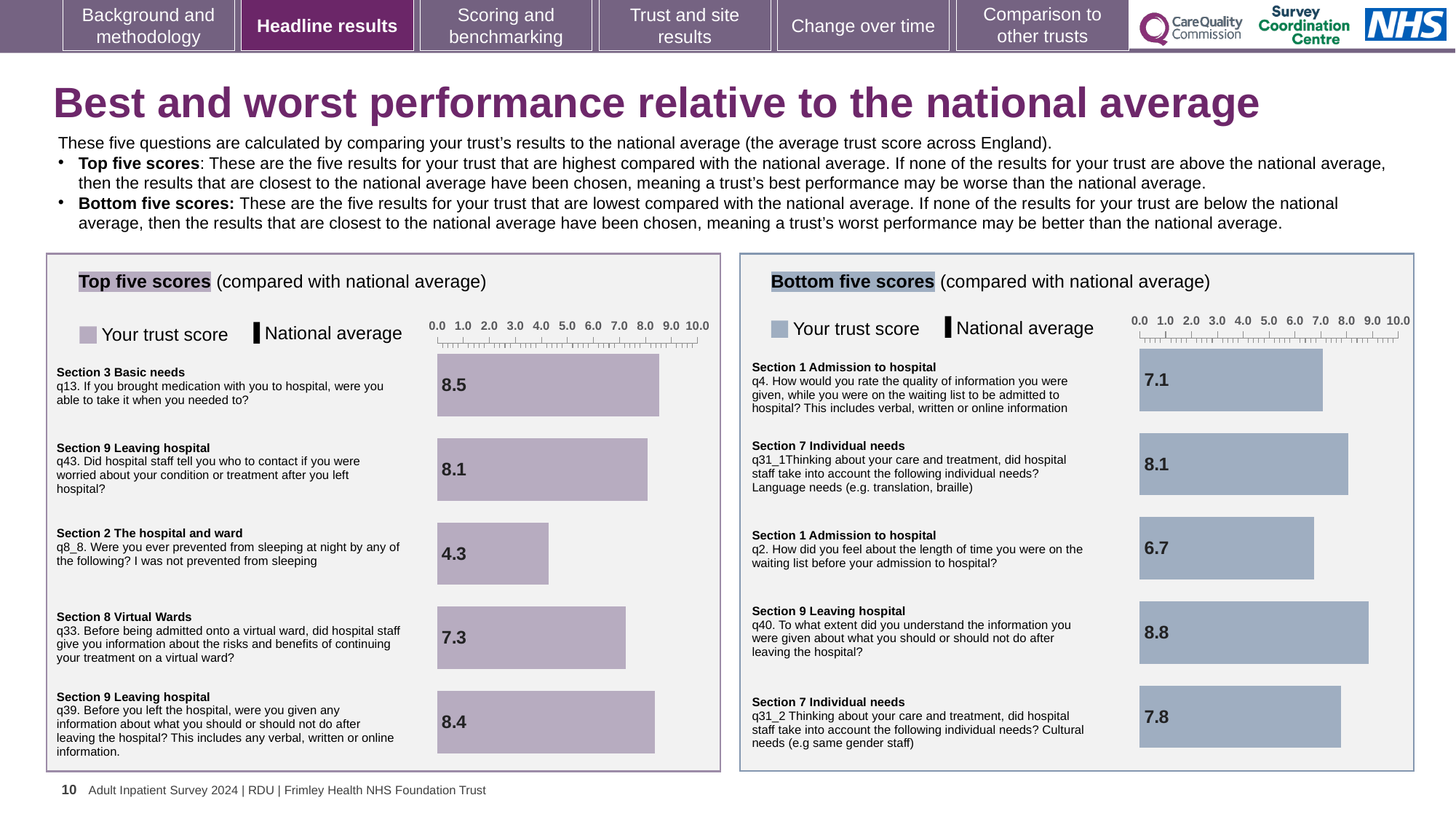
How many bars are shown in the Bottom five scores chart? 5 In the Top five scores chart, which question has the highest trust score? q13 In the Bottom five scores chart, which has the larger score: q31_1 or q31_2? q31_1 In the Bottom five scores chart, what is the trust score for q40 (Section 9 Leaving hospital)? 8.8 In the Top five scores chart, what is the difference between the scores for q13 and q8_8? 4.2 What type of chart is the Top five scores chart? bar chart In the Top five scores chart, which question has the lowest trust score? q8_8 In the Bottom five scores chart, which question has the highest trust score? q40 In the Top five scores chart, is the score for q33 greater or less than 5.0? greater In the Bottom five scores chart, which question has the lowest trust score? q2 In the Top five scores chart, what is the trust score for q13 (Section 3 Basic needs)? 8.5 In the Bottom five scores chart, what is the difference between the scores for q40 and q4? 1.7